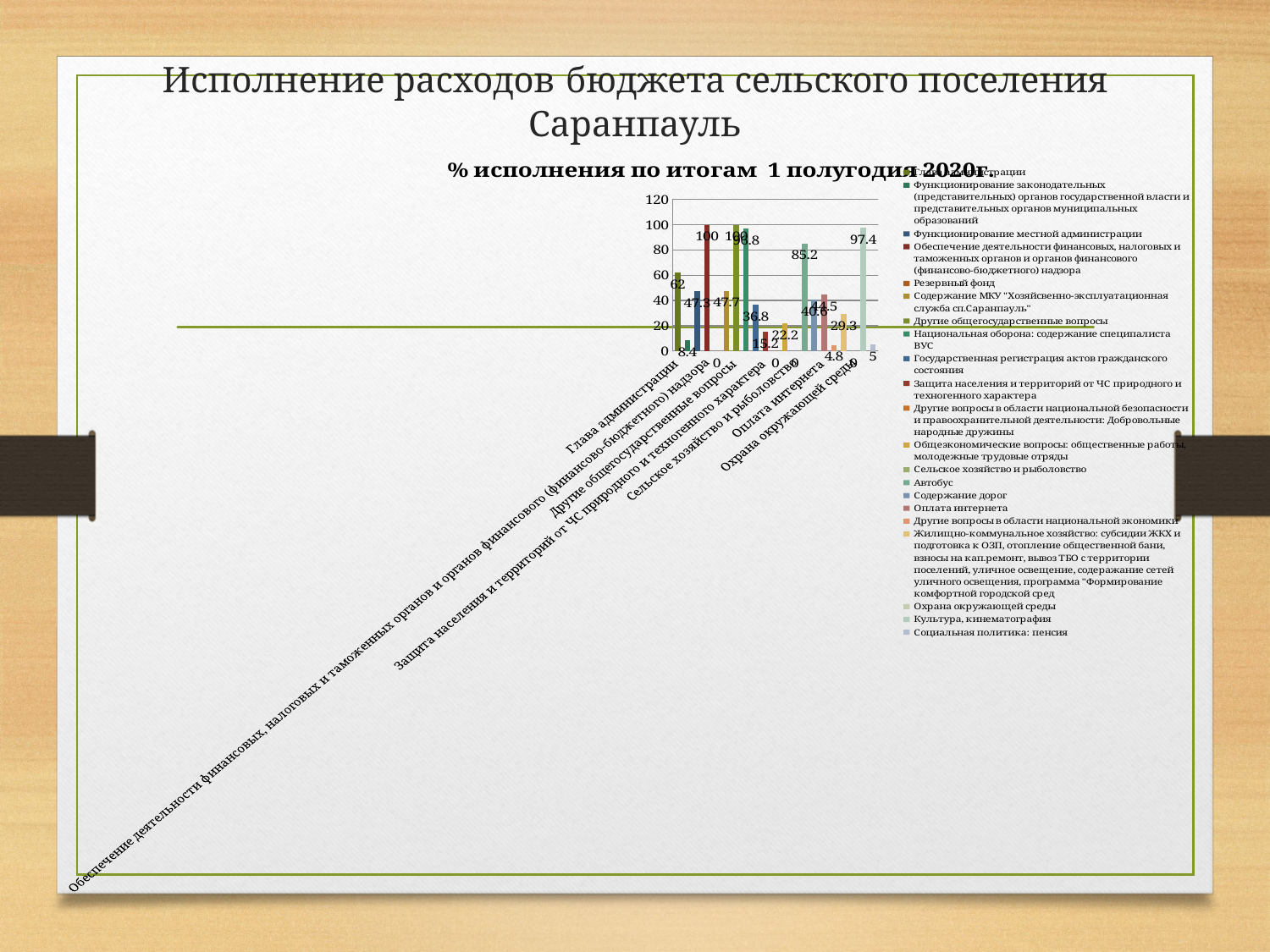
What is the value for Социальная политика: пенсия? 5 What is the value for Культура, кинематография? 97.4 What is the value for Национальная оборона: содержание специалиста ВУС? 96.8 What is the highest value shown on the vertical axis? 120 Is the value for Глава администрации greater or less than 40? greater Which is larger, the value for Автобус or the value for Глава администрации? Автобус How many series does the chart legend list? 21 What is the value for Глава администрации? 62 What is the difference between the value for Культура, кинематография and the value for Автобус? 12.2 What is the value for Автобус? 85.2 What is the title of the chart? % исполнения по итогам 1 полугодия 2020г. What kind of chart is shown on the slide? bar chart